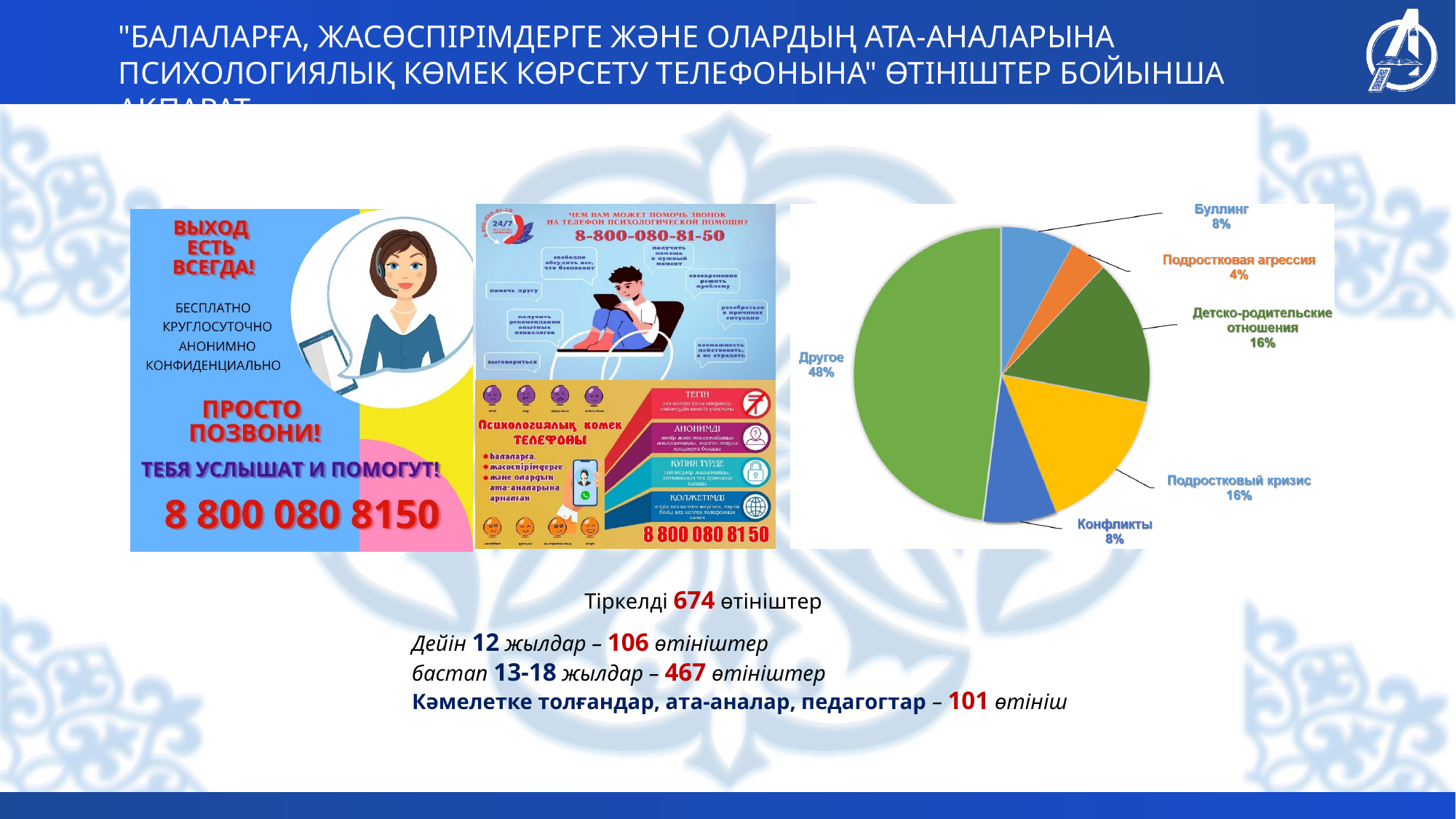
Which category has the smallest slice in the pie chart? Подростковая агрессия In the pie chart, what share is labelled for Детско-родительские отношения? 16% In the pie chart, what share is labelled for Буллинг? 8% In the pie chart, what is the difference between the shares for Другое and Подростковый кризис? 32% In the pie chart, what colour is the slice for Подростковый кризис? yellow Which category has the largest slice in the pie chart? Другое In the pie chart, which is larger: the share for Детско-родительские отношения or the share for Конфликты? Детско-родительские отношения What kind of chart is shown on the right side of the slide? pie chart In the pie chart, what share is labelled for Другое? 48% In the pie chart, what share is labelled for Подростковая агрессия? 4% How many slices does the pie chart have? 6 In the pie chart, what share is labelled for Конфликты? 8%